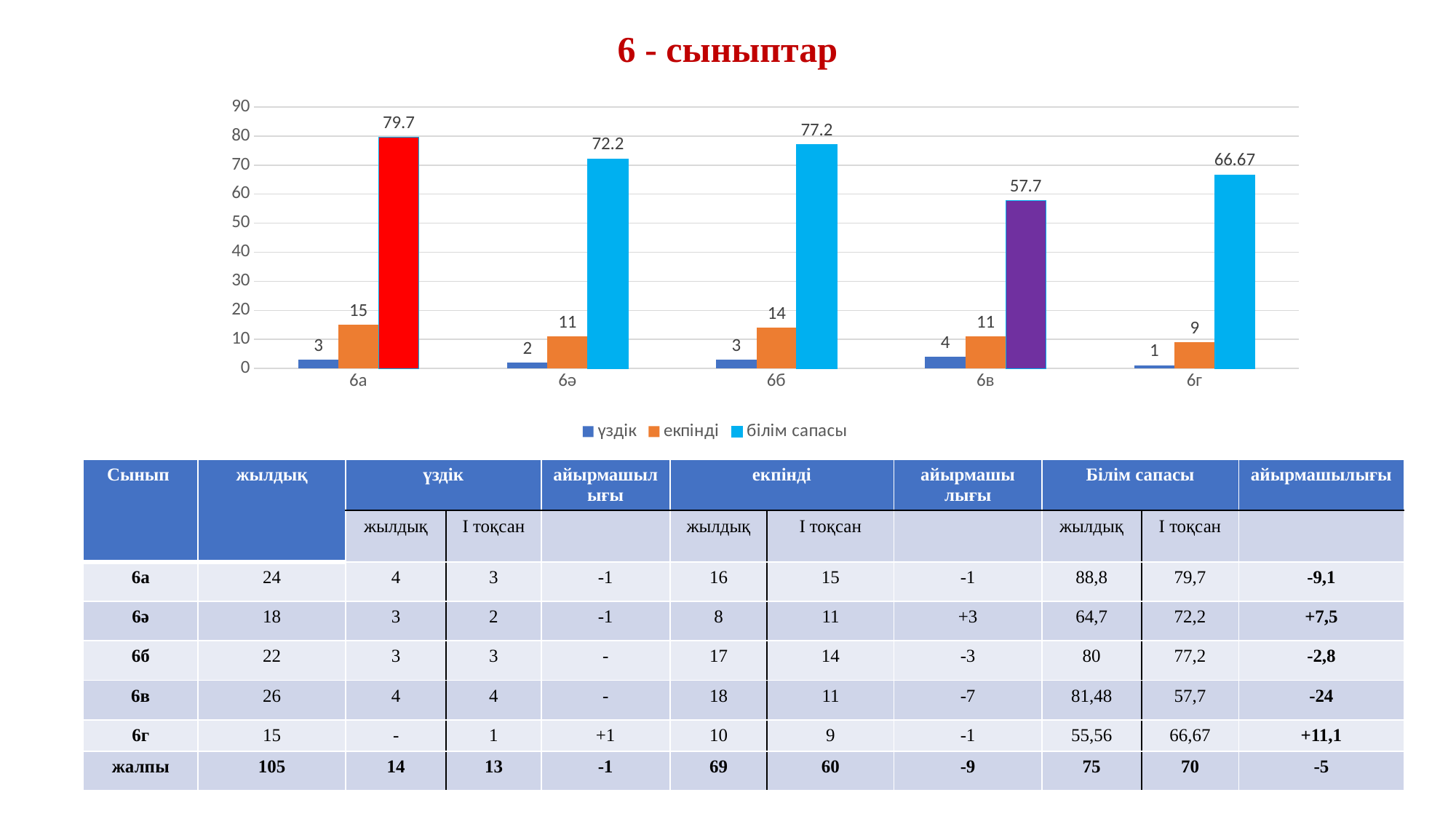
Which is larger, the екпінді value for 6а or for 6г? 6а What kind of chart is shown on the slide? bar chart What is the value of екпінді for 6б? 14 Which category has the lowest үздік value? 6г What is the difference between the білім сапасы values for 6ә and 6в? 14.5 How many series does the chart legend list? 3 What is the value of үздік for 6в? 4 Is the білім сапасы value for 6г greater or less than 70? less Which category has the highest білім сапасы value? 6а How many categories are shown on the x axis of the chart? 5 Which category has the lowest білім сапасы value? 6в What is the value of білім сапасы for 6а? 79.7